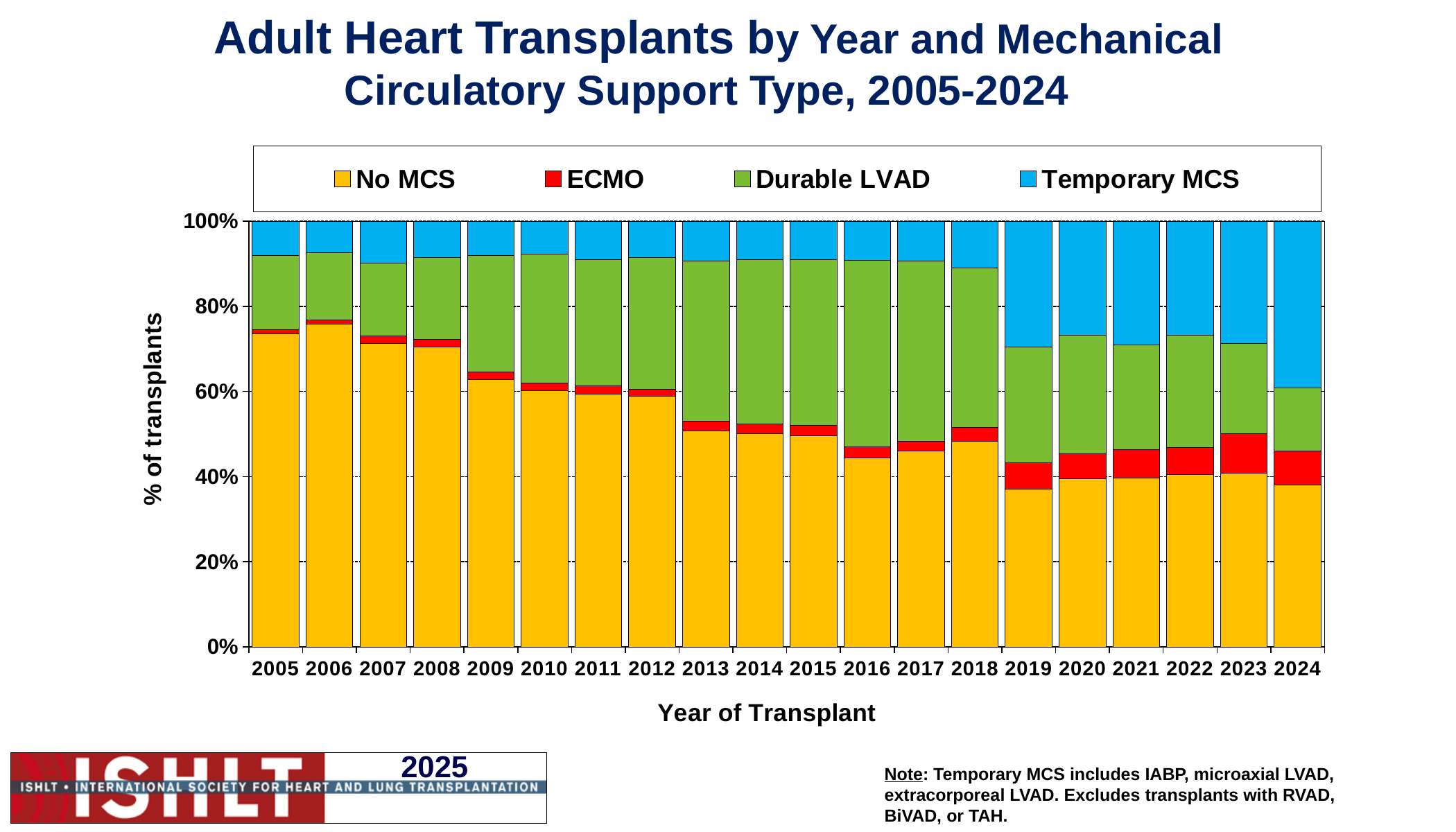
Is the Temporary MCS share in 2024 greater or less than 20%? greater What is the label of the y axis? % of transplants Is the No MCS share in 2019 greater or less than 40%? less Is the No MCS share in 2005 greater or less than 60%? greater Which year has the largest Temporary MCS share? 2024 How many series does the legend list? 4 How many years are shown along the x axis? 20 What does each stacked bar total? 100% Does the No MCS share rise or fall from 2005 to 2024? Fall What kind of chart is shown on the slide? Stacked bar chart Which year has the larger No MCS share, 2005 or 2024? 2005 Which series is shown in yellow in the legend? No MCS